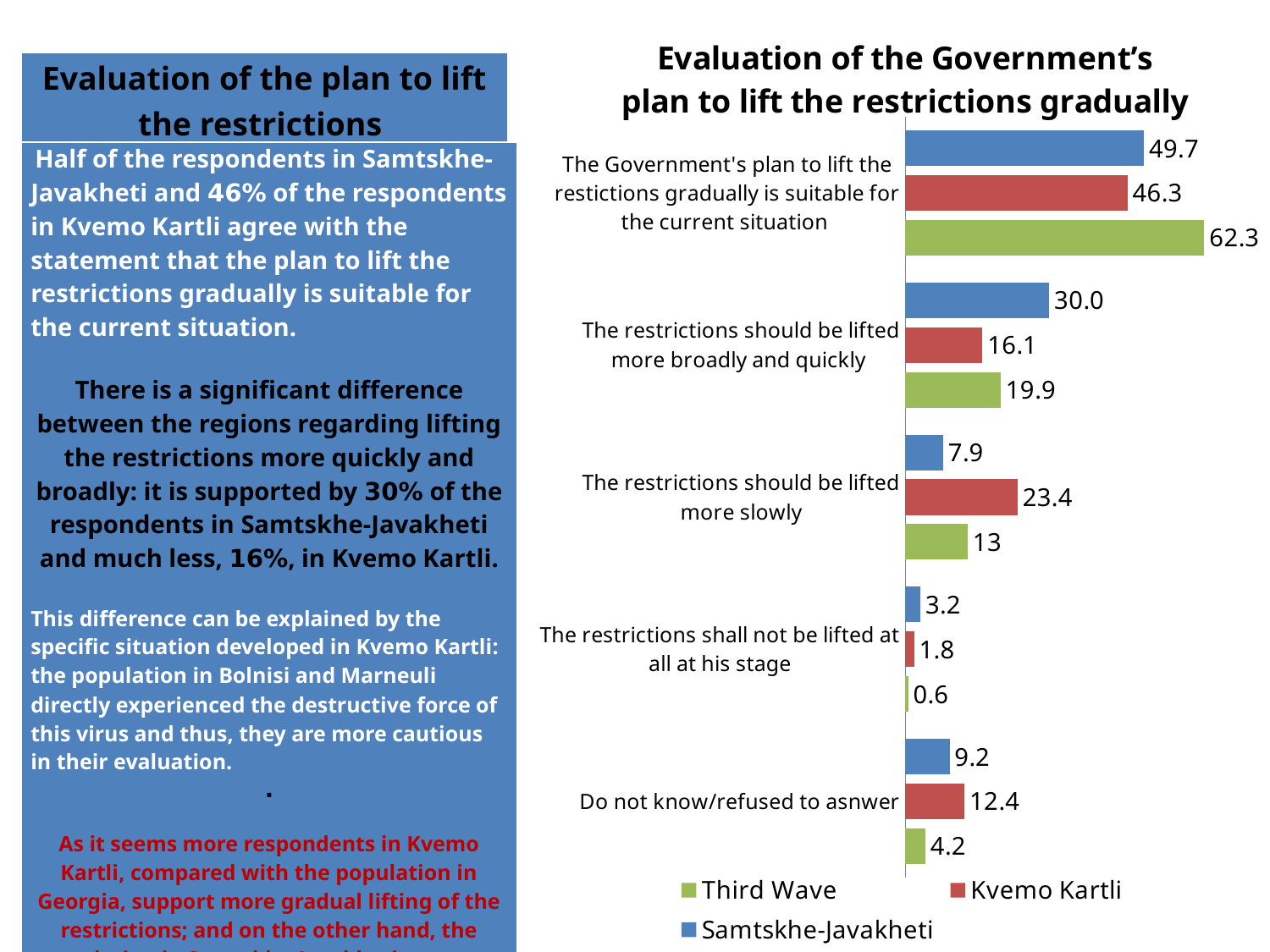
What kind of chart is shown on the slide? Bar chart How many categories are shown on the chart? 5 What is the Third Wave value for "Do not know/refused to asnwer"? 4.2 What is the Kvemo Kartli value for "The restrictions should be lifted more slowly"? 23.4 Which colour represents the Kvemo Kartli series in the chart? Red What is the difference between the Samtskhe-Javakheti and Kvemo Kartli values for "The restrictions should be lifted more broadly and quickly"? 13.9 What is the Samtskhe-Javakheti value for "The Government's plan to lift the restictions gradually is suitable for the current situation"? 49.7 Which category has the highest Third Wave value? The Government's plan to lift the restictions gradually is suitable for the current situation What is the difference between the Third Wave and Samtskhe-Javakheti values for "The Government's plan to lift the restictions gradually is suitable for the current situation"? 12.6 Which category has the lowest Kvemo Kartli value? The restrictions shall not be lifted at all at his stage How many series does the legend list? 3 For "The restrictions should be lifted more slowly", which series has the larger value: Samtskhe-Javakheti or Kvemo Kartli? Kvemo Kartli